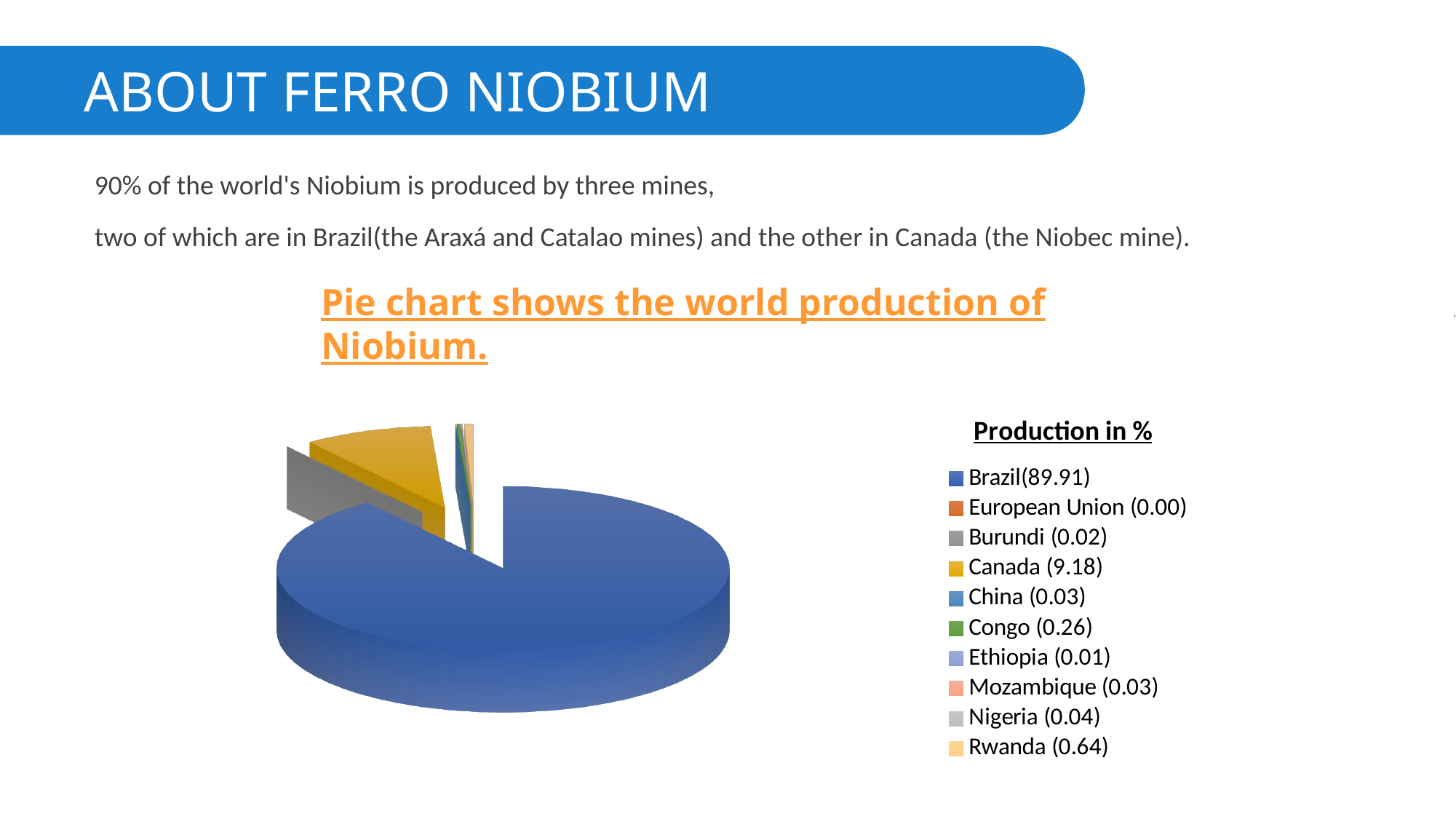
How many countries or regions are listed in the pie chart legend? 10 Which country has the largest share of the pie chart? Brazil Which has a larger production value, Congo or Rwanda? Rwanda What is the heading shown above the pie chart legend? Production in % What is the production value for Rwanda in the pie chart? 0.64 What is the difference between the production values of Brazil and Canada? 80.73 What is the production value for Congo in the pie chart? 0.26 What is the difference between the production values of Canada and Rwanda? 8.54 What is the production value for Canada in the pie chart? 9.18 Which legend entry has the lowest production value in the pie chart? European Union What kind of chart is shown on the slide? pie chart What is the production value for Brazil in the pie chart? 89.91